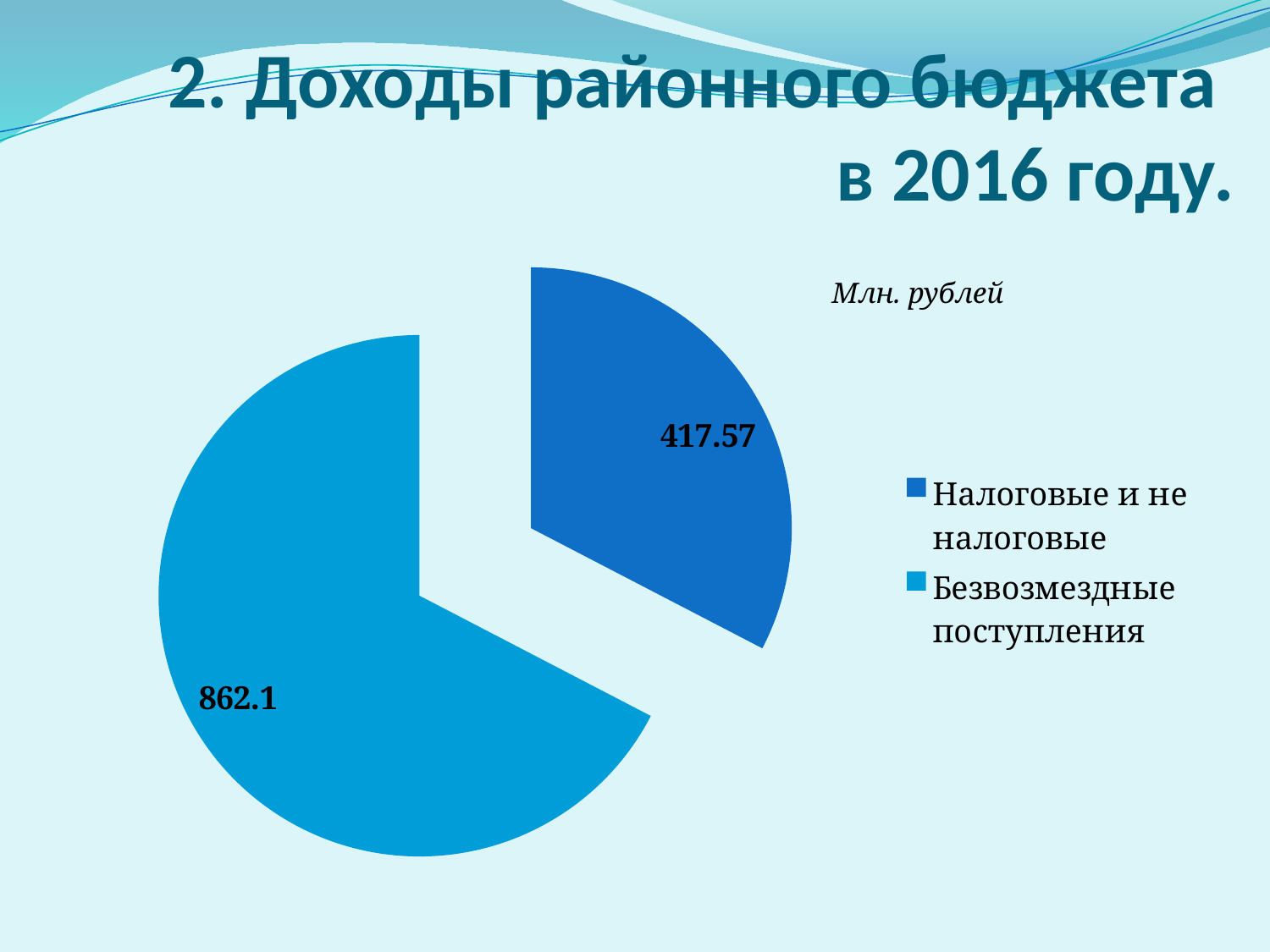
What is the value for Безвозмездные поступления on the pie chart? 862.1 What is the value for Налоговые и не налоговые on the pie chart? 417.57 Which category has the smallest slice of the pie chart? Налоговые и не налоговые How many slices does the pie chart have? 2 What is the title of the slide containing the pie chart? 2. Доходы районного бюджета в 2016 году. What is the difference between the values for Безвозмездные поступления and Налоговые и не налоговые? 444.53 What unit of measurement is indicated for the chart values? Млн. рублей How many entries does the legend list? 2 Which is larger: Налоговые и не налоговые or Безвозмездные поступления? Безвозмездные поступления What is the total of the two slices in the pie chart? 1279.67 What kind of chart is shown on the slide? Pie chart Which category has the largest slice of the pie chart? Безвозмездные поступления